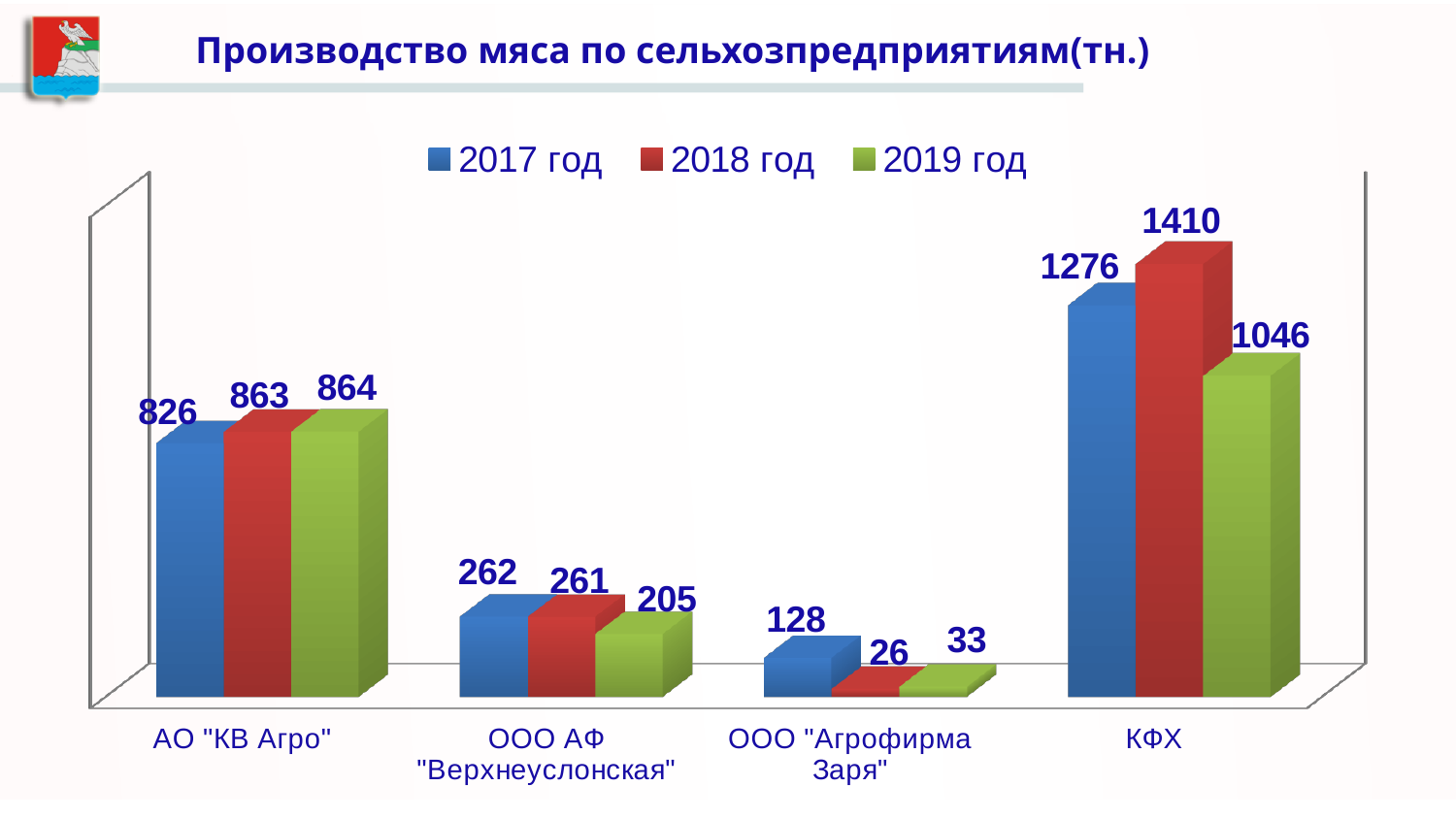
Which is larger for АО "КВ Агро": the 2017 год value or the 2019 год value? 2019 год What is the 2017 год value for ООО "Агрофирма Заря"? 128 What is the difference between the 2017 год and 2019 год values for ООО АФ "Верхнеуслонская"? 57 What is the title of the chart? Производство мяса по сельхозпредприятиям(тн.) What kind of chart is shown on the slide? bar chart How many series does the legend list? 3 How many categories are shown on the x axis? 4 What is the 2018 год value for КФХ? 1410 What is the 2019 год value for ООО АФ "Верхнеуслонская"? 205 Which category has the highest 2019 год value? КФХ What is the difference between the 2018 год and 2017 год values for КФХ? 134 Which category has the lowest 2018 год value? ООО "Агрофирма Заря"